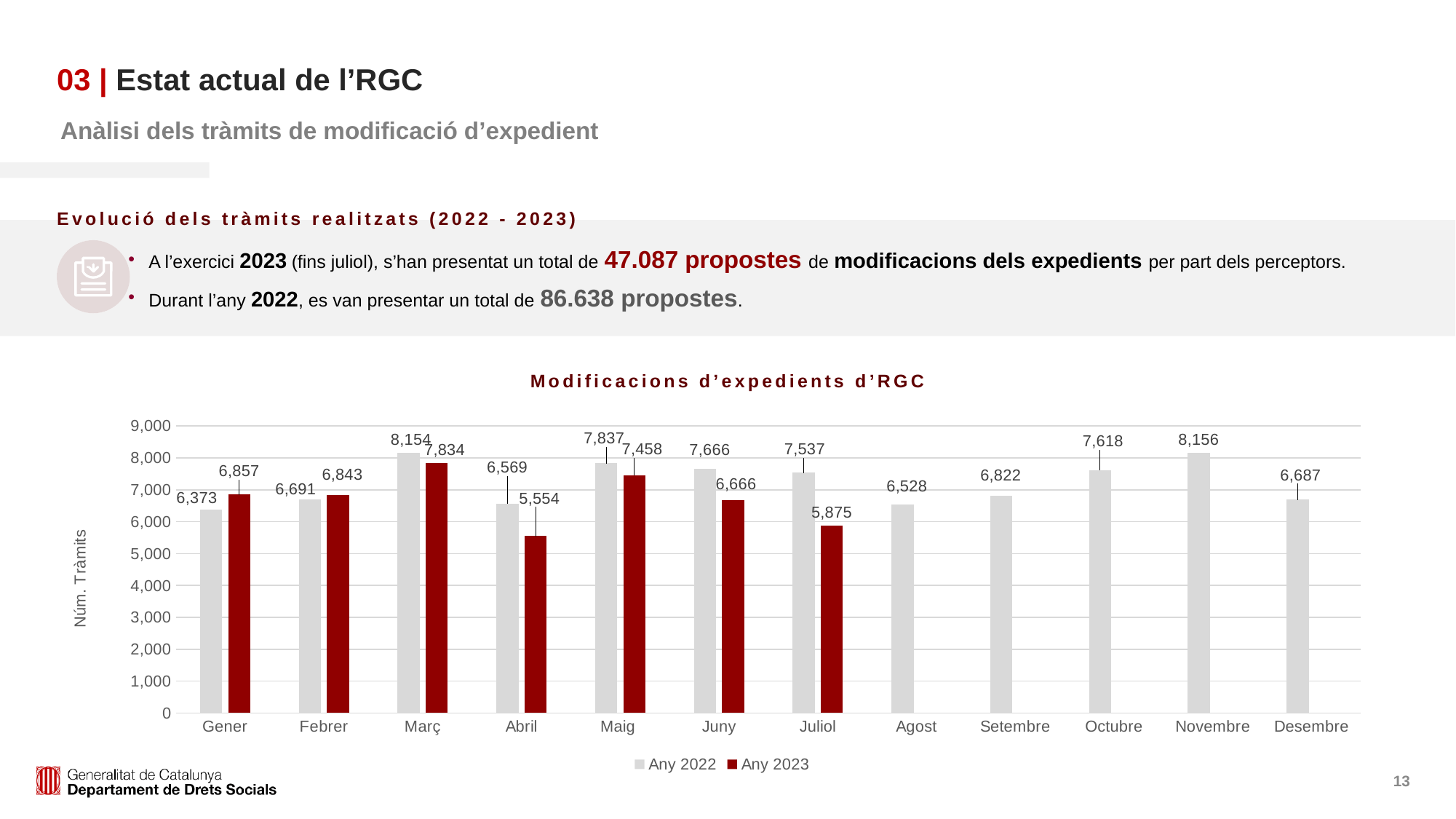
What is the value for Any 2022 in Octubre? 7,618 How many series does the legend list? 2 Which month has the lowest value for Any 2022? Gener What is the value for Any 2022 in Març? 8,154 In Maig, which series has the larger value, Any 2022 or Any 2023? Any 2022 What is the difference between the Any 2022 and Any 2023 values in Abril? 1,015 Which month has the lowest value for Any 2023? Abril Is the value for Any 2022 in Novembre greater or less than 8,000? greater Which month has the highest value for Any 2023? Març What is the value for Any 2023 in Juliol? 5,875 What is the difference between the Any 2023 and Any 2022 values in Gener? 484 How many months are shown on the x axis? 12